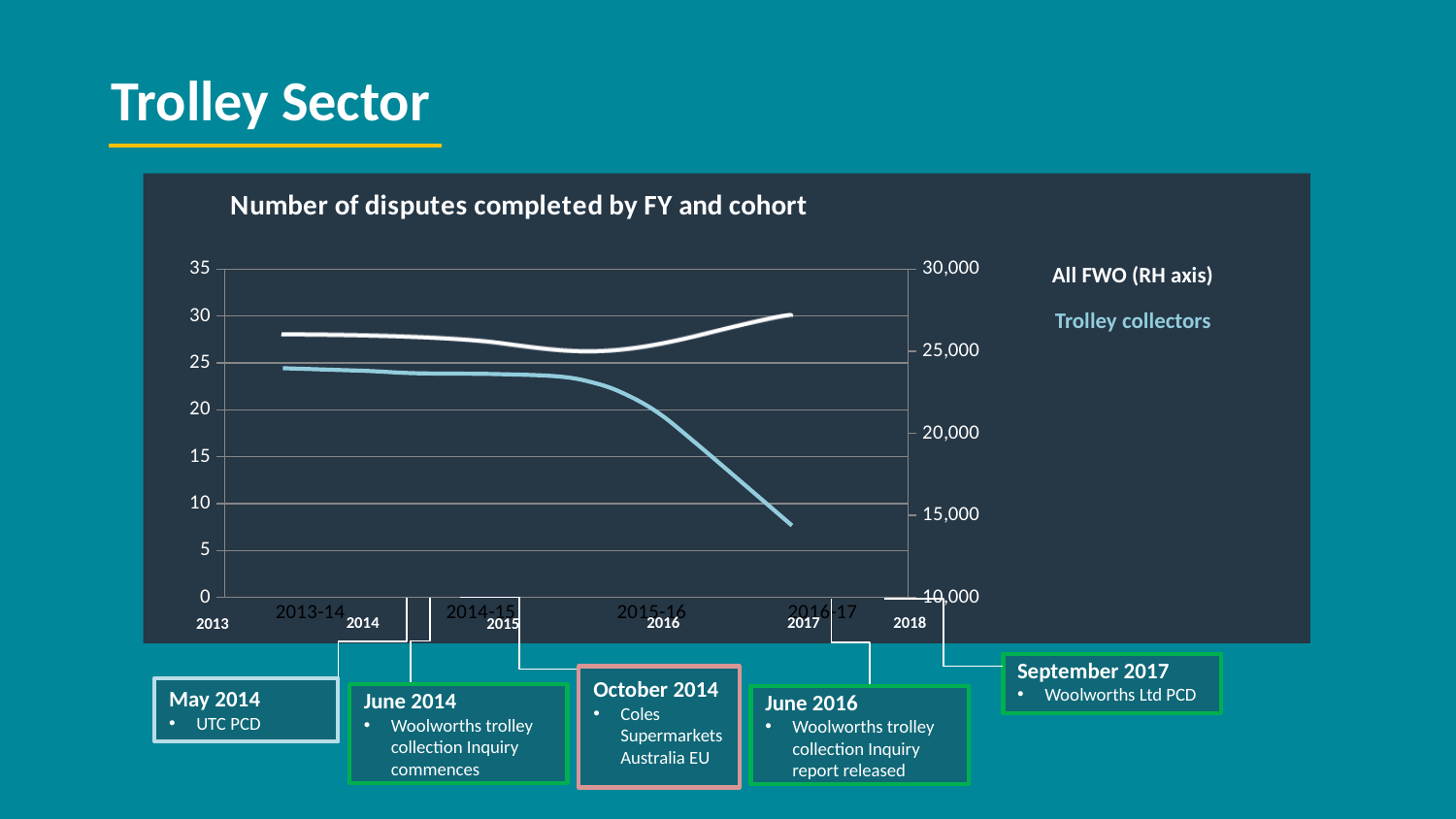
Is the Trolley collectors value for 2016-17 greater or less than 10? less In which financial year is the All FWO value highest? 2016-17 Is the All FWO value for 2016-17 greater or less than 25,000? greater Is the Trolley collectors value for 2013-14 greater or less than 20? greater Do the values for Trolley collectors rise or fall from 2013-14 to 2016-17? fall What kind of chart is shown on the slide? line chart In which financial year is the Trolley collectors value lowest? 2016-17 For All FWO, which is larger: the value for 2015-16 or the value for 2016-17? 2016-17 Which series is plotted against the right-hand axis? All FWO What is the title of the chart? Number of disputes completed by FY and cohort How many series does the chart's legend list? 2 How many financial years are plotted along the x axis? 4